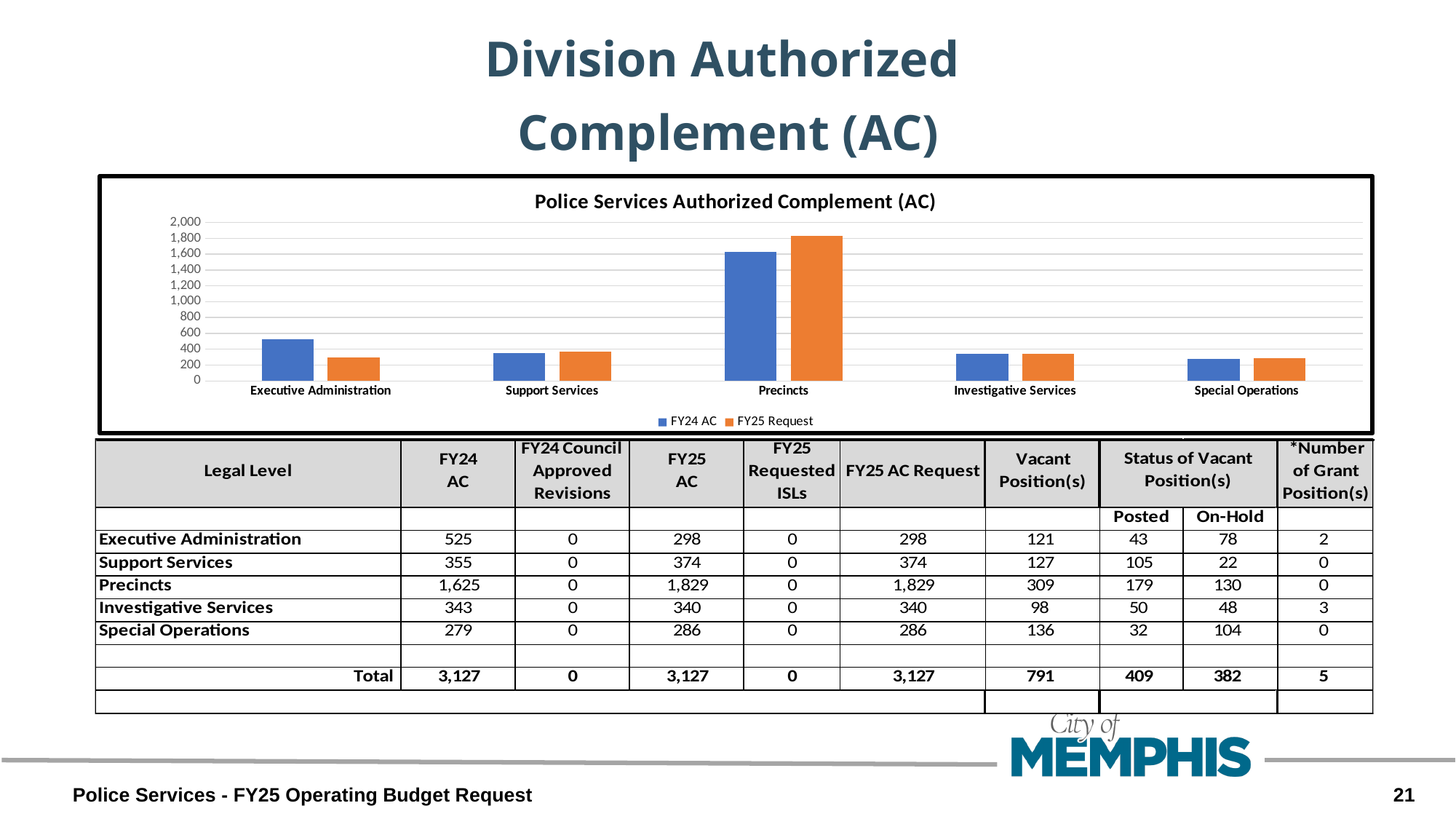
Which category has the highest FY24 AC value in the chart? Precincts Is the FY25 Request value for Precincts greater or less than 1,600? greater What is the FY24 AC value for Precincts, as printed in the table below the chart? 1,625 For Precincts, which is larger: the FY24 AC bar or the FY25 Request bar? FY25 Request How many categories are shown on the x axis of the chart? 5 For Executive Administration, which is larger: the FY24 AC bar or the FY25 Request bar? FY24 AC What is the title of the chart? Police Services Authorized Complement (AC) Is the FY24 AC value for Special Operations greater or less than 400? less What kind of chart is shown on the slide? bar chart Which category has the lowest FY25 Request value in the chart? Special Operations How many series does the chart legend list? 2 What is the FY25 AC Request value for Support Services, as printed in the table below the chart? 374